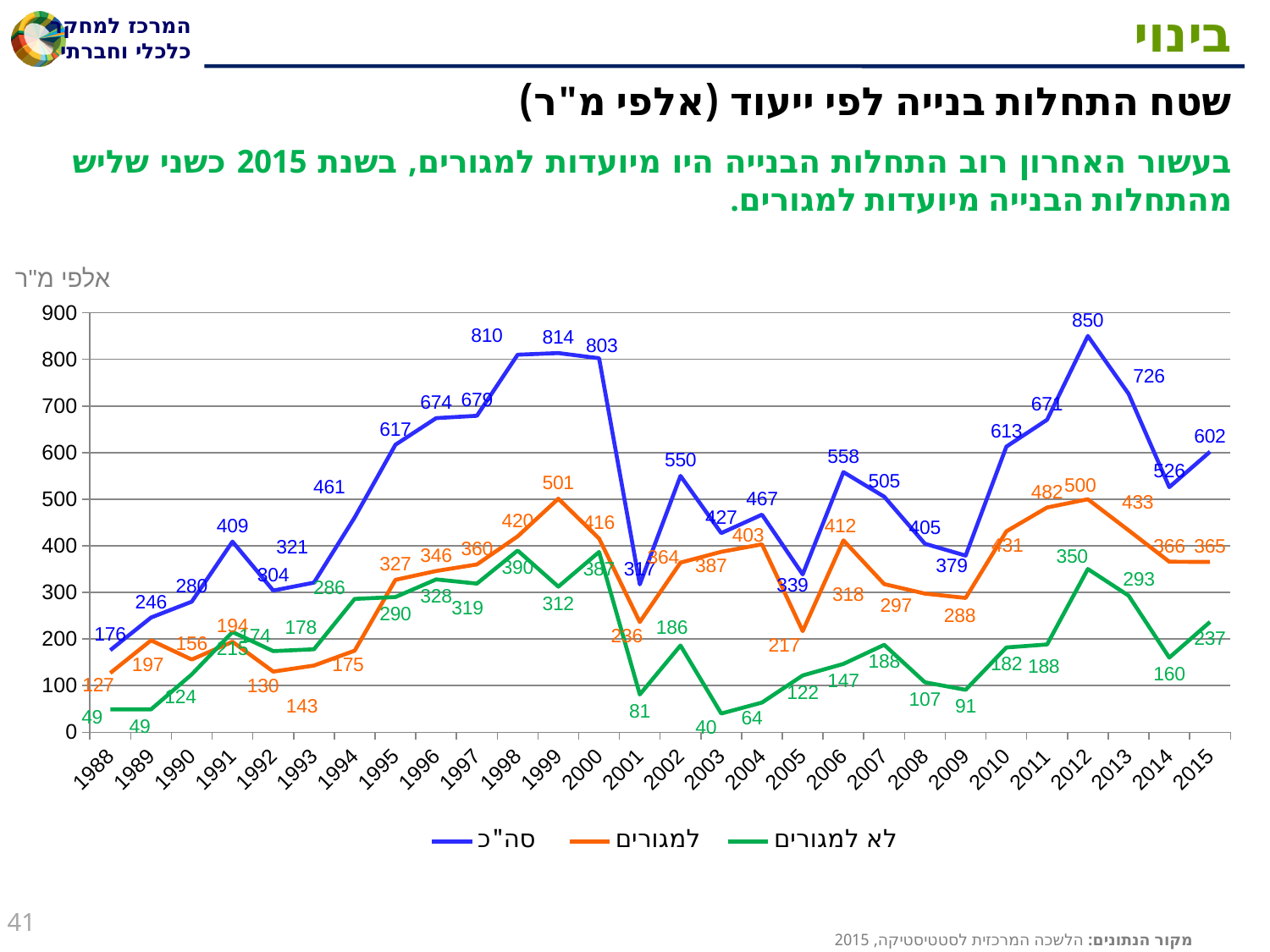
In which year is the למגורים series highest? 1999 How many years are shown on the x axis? 28 In which year is the לא למגורים series lowest? 2003 What is the value of סה"כ in 2012? 850 Which is larger, the סה"כ value in 2006 or in 2007? 2006 How many series does the legend list? 3 What is the value of למגורים in 2015? 365 What kind of chart is shown on the slide? line chart In which year is the סה"כ series highest? 2012 Does the סה"כ series rise or fall from 2012 to 2014? fall What is the value of לא למגורים in 2003? 40 What is the difference between סה"כ and למגורים in 2015? 237